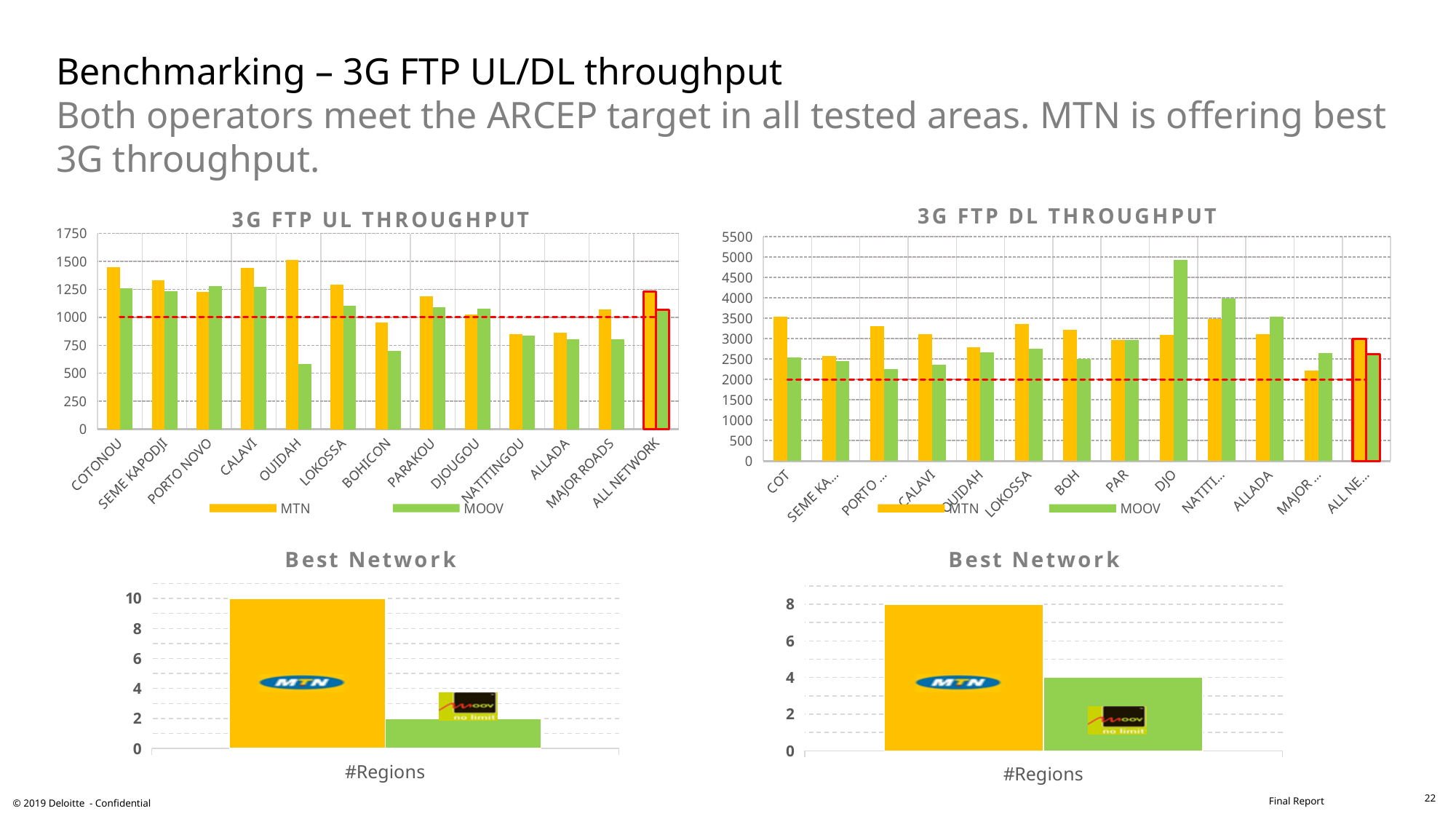
How many series does the legend of the "3G FTP DL THROUGHPUT" chart list? 2 In the "3G FTP DL THROUGHPUT" chart, which category has the highest MOOV value? DJO In the bottom-right "Best Network" chart, what is the difference between the MTN and MOOV number of regions? 4 In the "3G FTP UL THROUGHPUT" chart, is the MTN value for OUIDAH greater or less than 1250? greater How many categories are shown on the x axis of the "3G FTP UL THROUGHPUT" chart? 13 In the "3G FTP DL THROUGHPUT" chart, is the MTN value for the MAJOR... category greater or less than 2500? less What are the two legend entries of the "3G FTP UL THROUGHPUT" chart? MTN and MOOV In the bottom-left "Best Network" chart, what is the number of regions for MOOV? 2 In the bottom-left "Best Network" chart, what is the number of regions for MTN? 10 What kind of chart is the "3G FTP UL THROUGHPUT" chart? bar chart In the "3G FTP DL THROUGHPUT" chart, is the MTN value for COT greater or less than 3000? greater